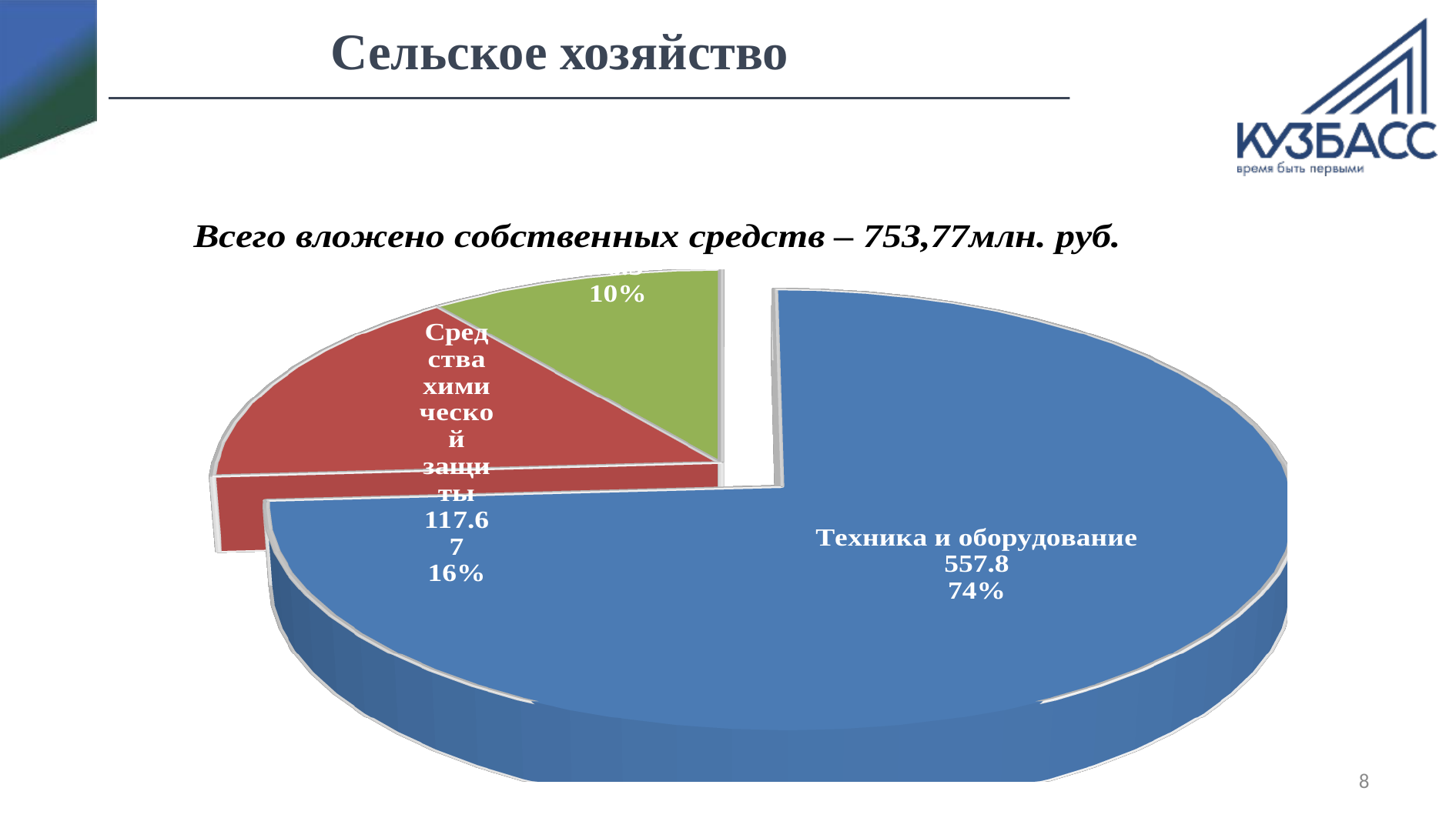
How many slices does the pie chart have? 3 Which slice of the pie chart is the largest? Техника и оборудование What kind of chart is shown on the slide? Pie chart What colour is the slice for "Техника и оборудование"? Blue Which is larger, "Техника и оборудование" or "Средства химической защиты"? Техника и оборудование What share of the pie does "Техника и оборудование" take? 74% What share of the pie does "Средства химической защиты" take? 16% What value is shown for the slice "Средства химической защиты"? 117.67 According to the text above the chart, what is the total amount of own funds invested? 753,77млн. руб. What value is shown for the slice "Техника и оборудование"? 557.8 What share of the pie does the green slice take? 10% What is the difference between the values for "Техника и оборудование" and "Средства химической защиты"? 440.13